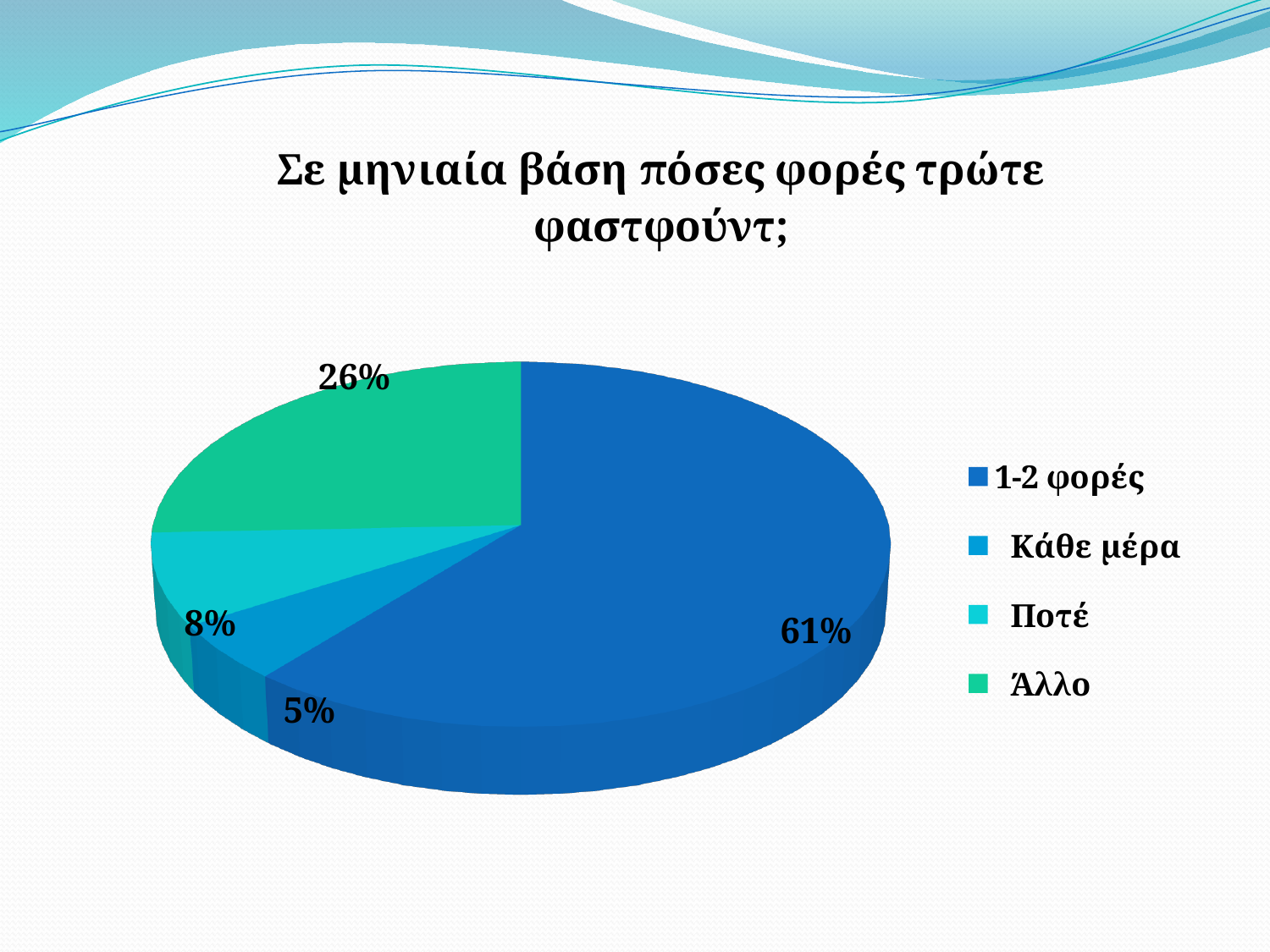
What percentage of the pie is labelled for 'Ποτέ'? 8% What percentage of the pie is labelled for 'Άλλο'? 26% What colour is the slice for 'Άλλο'? green Which category has the largest slice of the pie? 1-2 φορές Which is larger, the slice for 'Ποτέ' or the slice for 'Κάθε μέρα'? Ποτέ What percentage of the pie is labelled for '1-2 φορές'? 61% What is the difference in percentage points between '1-2 φορές' and 'Άλλο'? 35 Which category has the smallest slice of the pie? Κάθε μέρα What is the title of the chart? Σε μηνιαία βάση πόσες φορές τρώτε φαστφούντ; How many categories does the legend list? 4 What kind of chart is shown on the slide? pie chart What percentage of the pie is labelled for 'Κάθε μέρα'? 5%